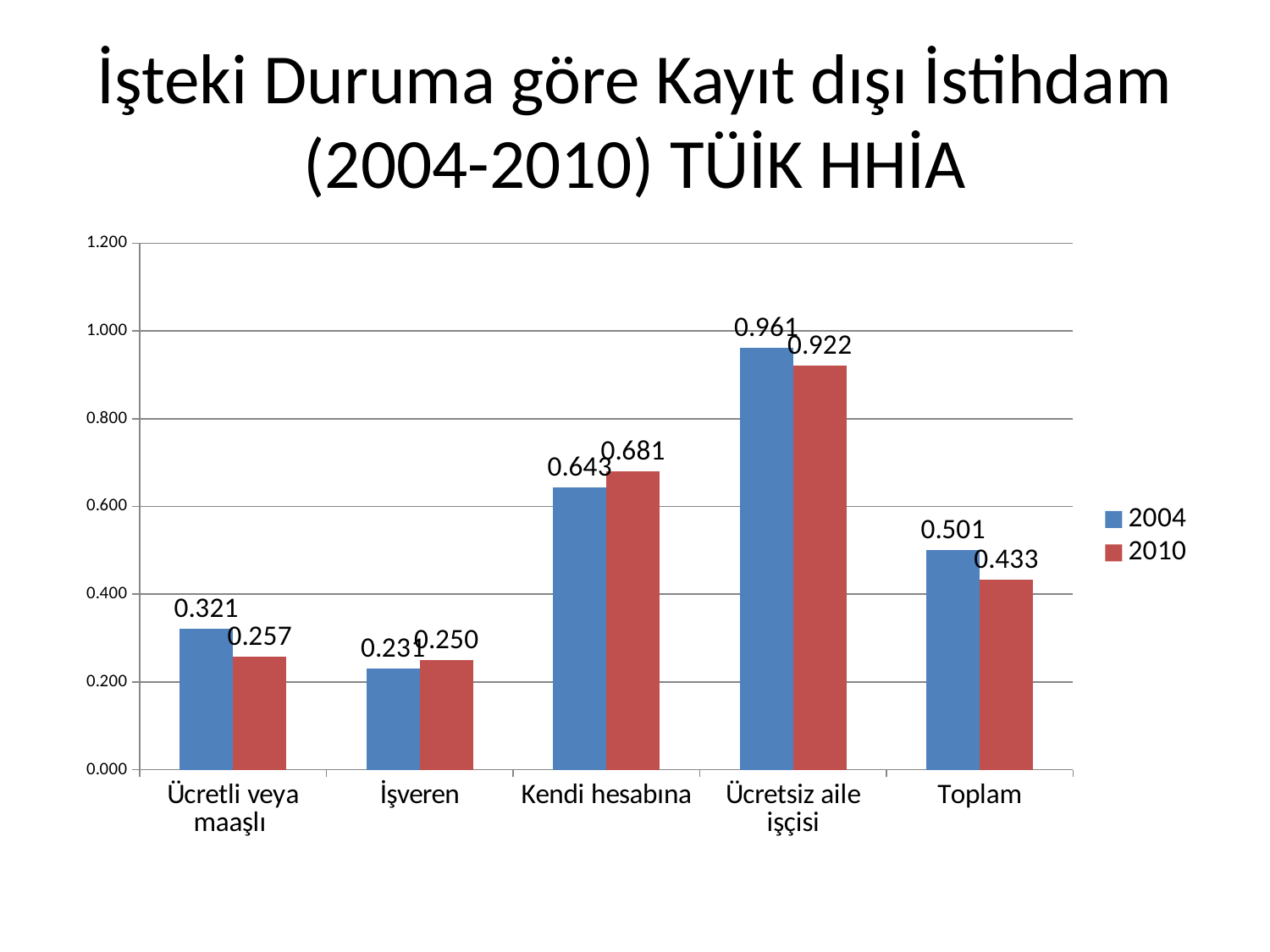
Which category has the lowest 2004 value? İşveren How many series does the legend list? 2 Which category has the highest 2010 value? Ücretsiz aile işçisi What is the 2010 value for Kendi hesabına? 0.681 What is the 2010 value for Toplam? 0.433 Which colour represents the 2010 series in the legend? Red What is the difference between the 2004 and 2010 values for Toplam? 0.068 What is the 2004 value for İşveren? 0.231 What is the 2004 value for Ücretsiz aile işçisi? 0.961 How many categories are shown on the x axis? 5 Which is larger for Ücretli veya maaşlı: the 2004 value or the 2010 value? 2004 What kind of chart is shown on the slide? Bar chart